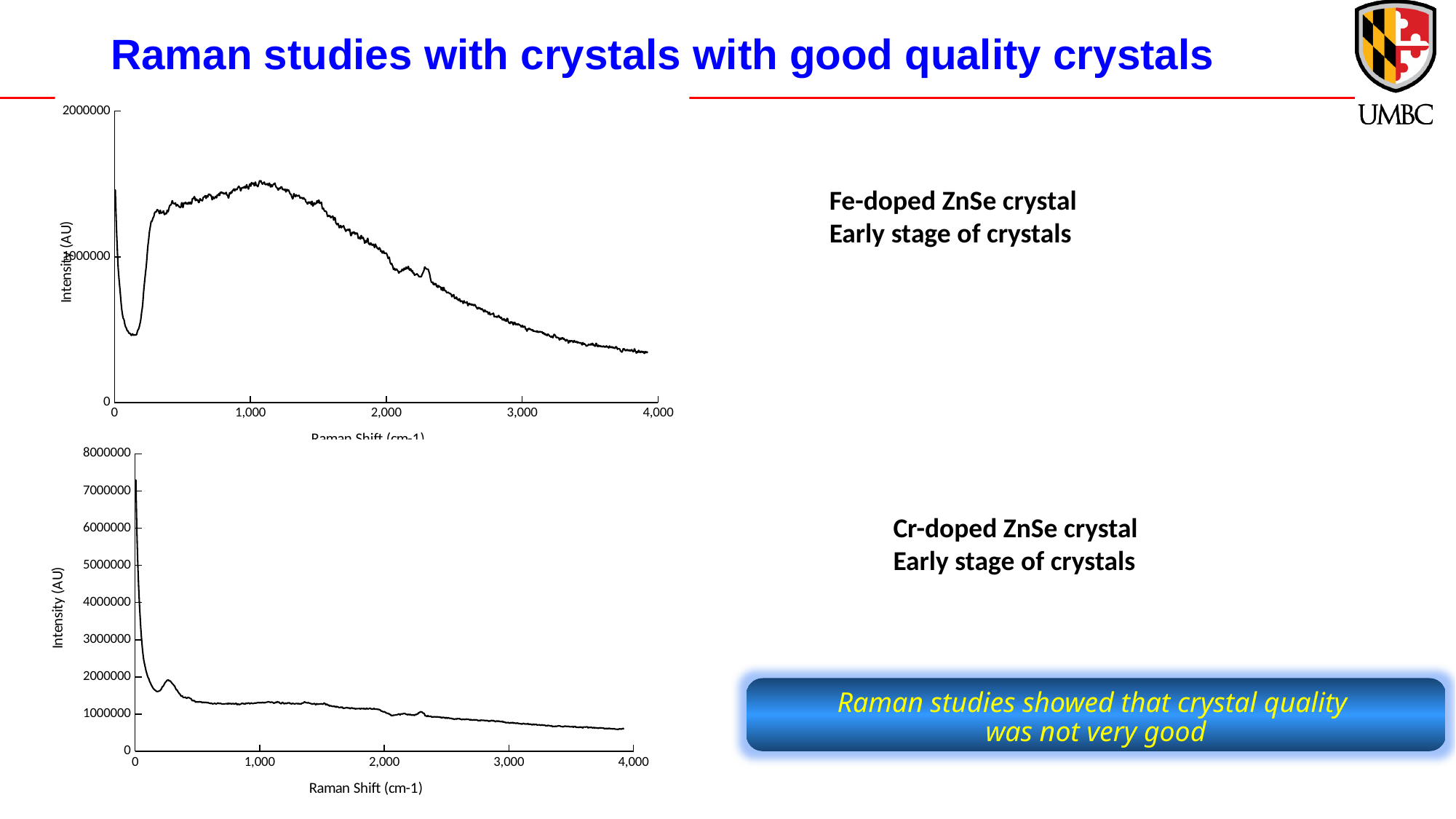
In the bottom chart (Cr-doped ZnSe crystal), what is the label of the x axis? Raman Shift (cm-1) In the bottom chart (Cr-doped ZnSe crystal), does the intensity rise or fall between Raman shifts of 0 and 1,000? fall What kind of chart is the bottom chart (Cr-doped ZnSe crystal)? line chart In the bottom chart (Cr-doped ZnSe crystal), is the intensity at a Raman shift of 3,000 greater or less than 1000000? less In the top chart (Fe-doped ZnSe crystal), what is the label of the y axis? Intensity (AU) In the bottom chart (Cr-doped ZnSe crystal), is the peak intensity near a Raman shift of 0 greater or less than 6000000? greater Which chart reaches a higher peak intensity, the top chart (Fe-doped ZnSe crystal) or the bottom chart (Cr-doped ZnSe crystal)? the bottom chart (Cr-doped ZnSe crystal) In the top chart (Fe-doped ZnSe crystal), is the intensity at a Raman shift of 3,000 greater or less than 1000000? less In the top chart (Fe-doped ZnSe crystal), does the intensity rise or fall between Raman shifts of 1,000 and 4,000? fall How many charts are shown on the slide? 2 What kind of chart is the top chart (Fe-doped ZnSe crystal)? line chart